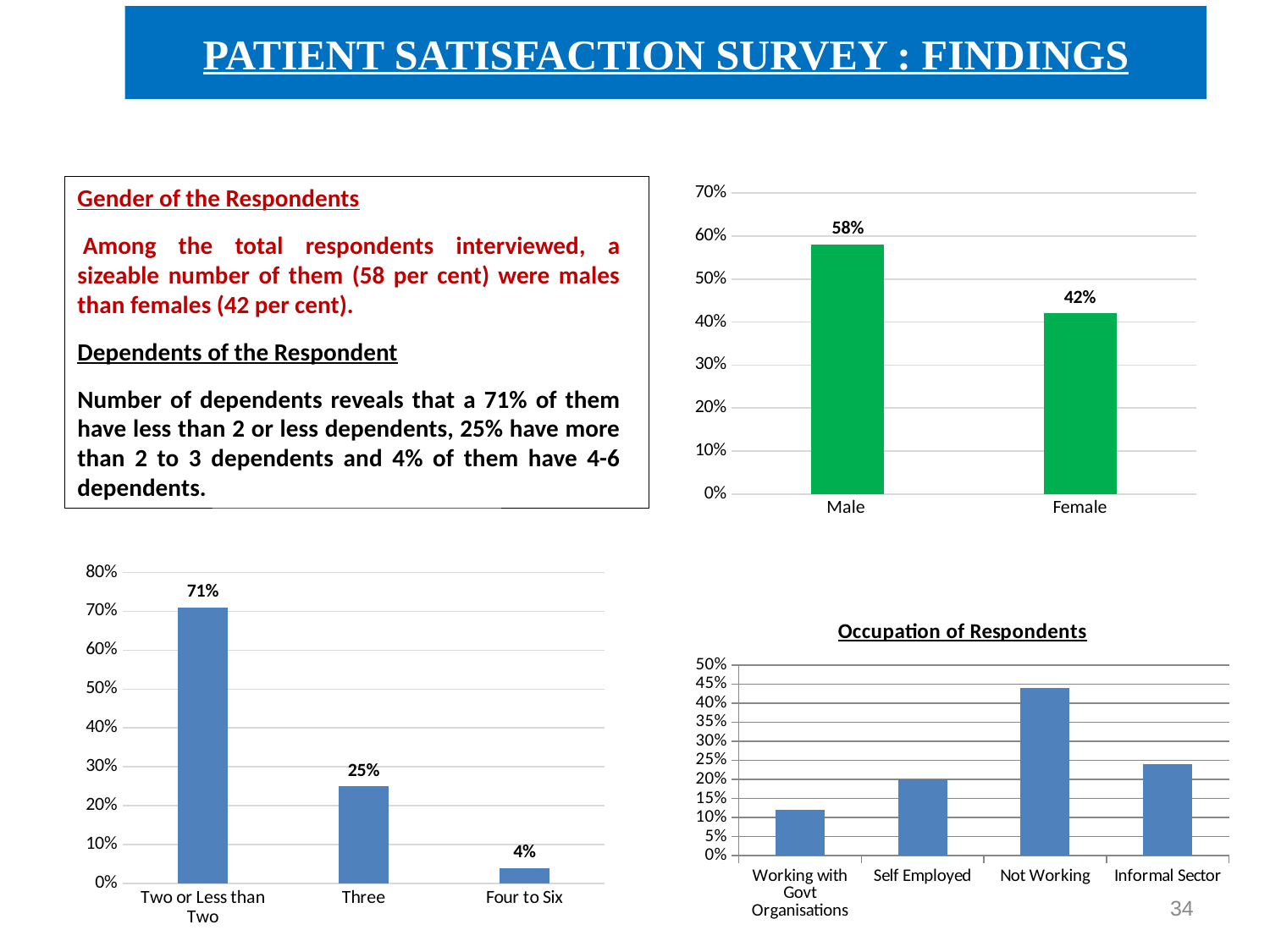
In the 'Occupation of Respondents' chart, which category has the highest value? Not Working In the bottom-left chart of dependents, which category has the highest value? Two or Less than Two In the top-right chart showing Male and Female, what is the value for Male? 58% In the bottom-left chart of dependents, which category has the lowest value? Four to Six What type of chart is the 'Occupation of Respondents' chart? Bar chart In the top-right chart showing Male and Female, what is the value for Female? 42% In the bottom-left chart of dependents, what is the value for Three? 25% In the bottom-left chart of dependents, what is the difference between the values for Two or Less than Two and Three? 46% In the top-right chart showing Male and Female, what is the difference between the Male and Female values? 16% In the 'Occupation of Respondents' chart, which is larger, Informal Sector or Self Employed? Informal Sector In the bottom-left chart of dependents, how many categories are shown? 3 In the 'Occupation of Respondents' chart, is the value for Working with Govt Organisations greater or less than 15%? less